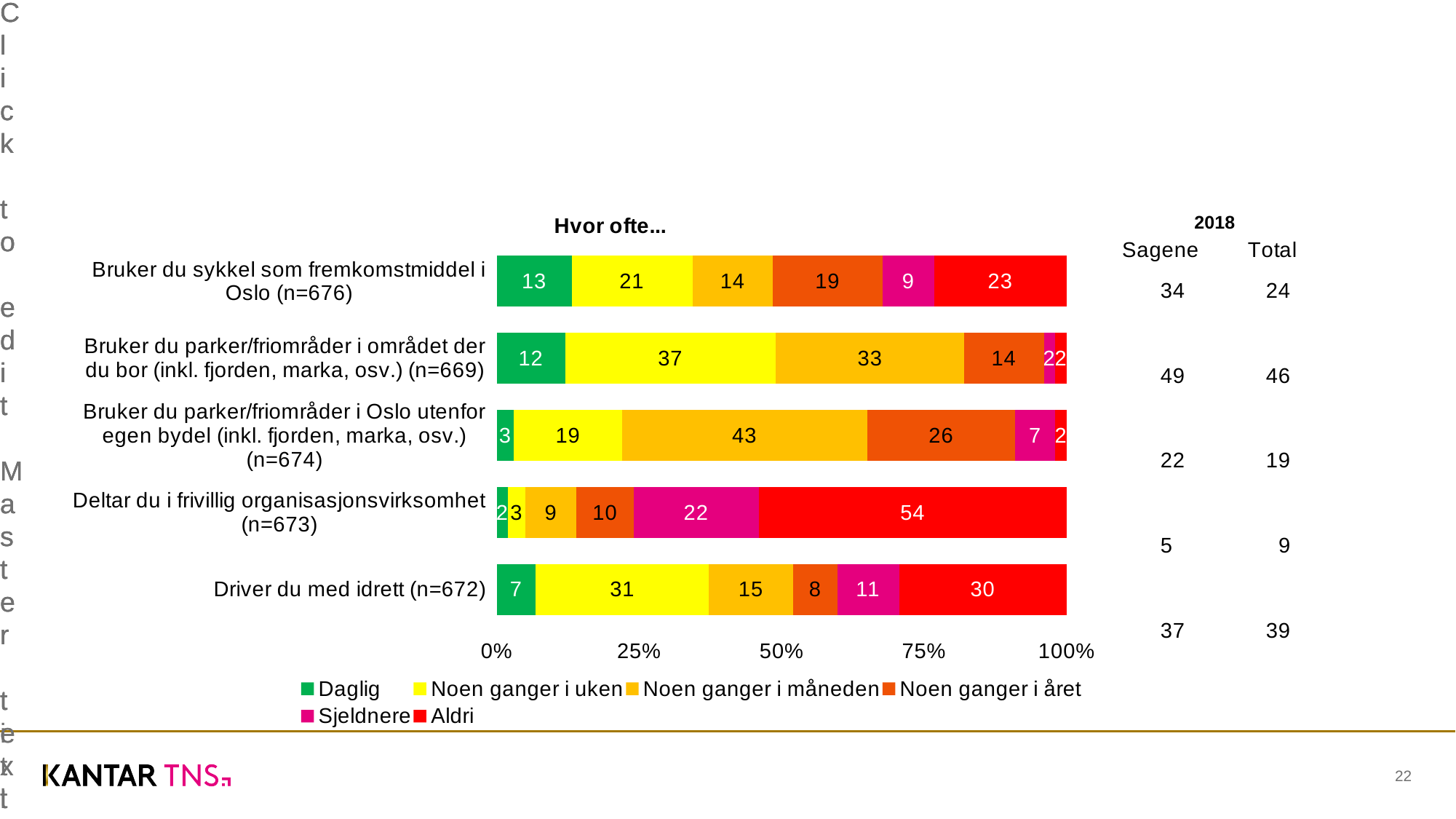
What is the difference between the 'Noen ganger i uken' values for 'Bruker du parker/friområder i området der du bor' and 'Driver du med idrett'? 6 Which category has the highest 'Aldri' value? Deltar du i frivillig organisasjonsvirksomhet (n=673) Which is larger: the 'Aldri' value for 'Driver du med idrett (n=672)' or for 'Bruker du sykkel som fremkomstmiddel i Oslo (n=676)'? Driver du med idrett (n=672) Which category has the lowest 'Daglig' value? Deltar du i frivillig organisasjonsvirksomhet (n=673) What is the 'Aldri' value for 'Deltar du i frivillig organisasjonsvirksomhet (n=673)'? 54 How many series does the chart legend list? 6 What colour represents the 'Sjeldnere' series in the legend? Pink/magenta What is the 'Daglig' value for 'Bruker du sykkel som fremkomstmiddel i Oslo (n=676)'? 13 What type of chart is shown on the slide? Stacked bar chart What is the title of the chart? Hvor ofte... What is the 'Noen ganger i måneden' value for 'Bruker du parker/friområder i Oslo utenfor egen bydel (inkl. fjorden, marka, osv.) (n=674)'? 43 How many question categories (bars) are shown in the chart? 5